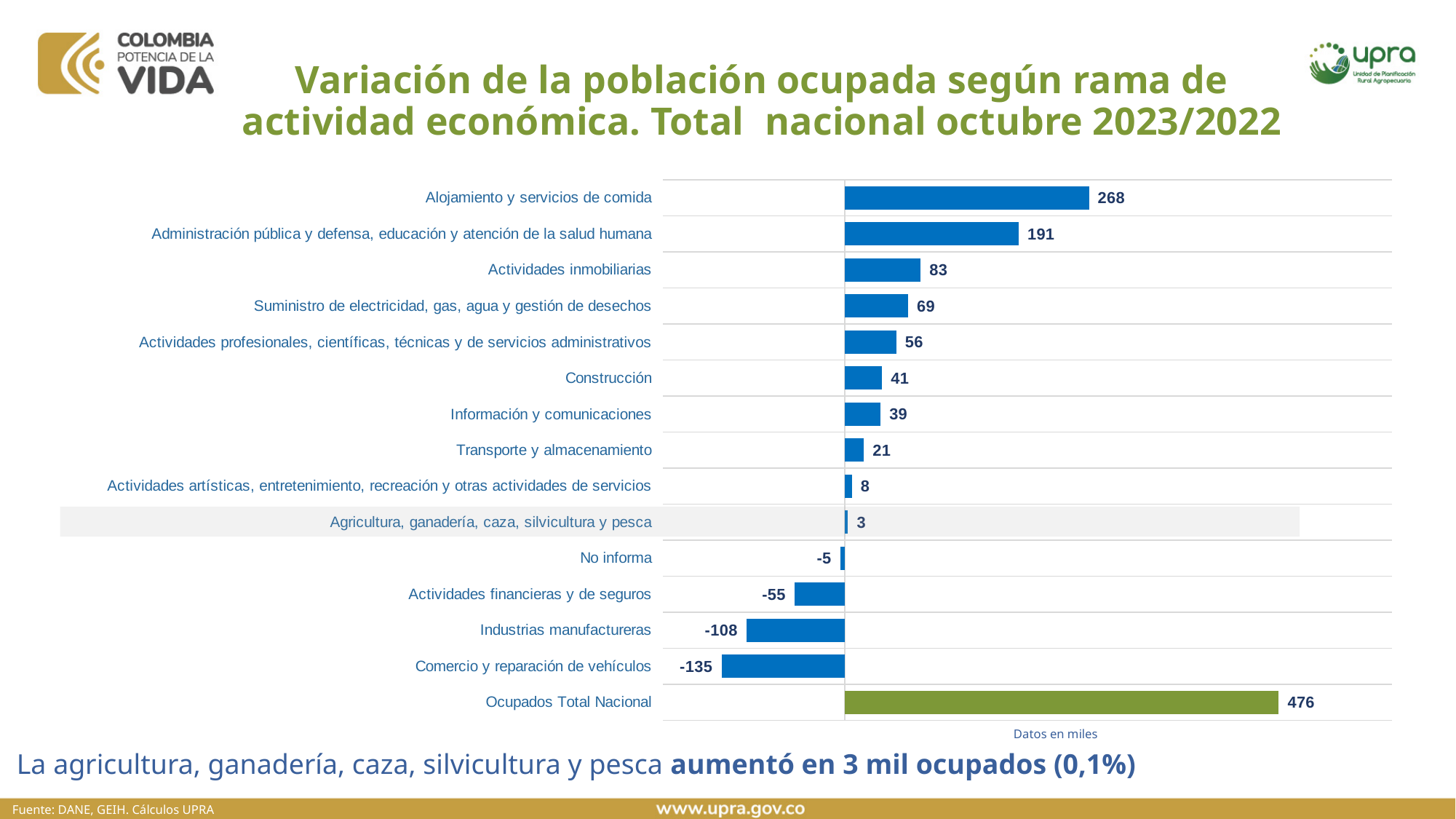
What is the value for Comercio y reparación de vehículos? -135 Which category has the lowest value? Comercio y reparación de vehículos What is the value for Ocupados Total Nacional? 476 What type of chart is shown on the slide? Bar chart What is the difference between the values for Alojamiento y servicios de comida and Administración pública y defensa, educación y atención de la salud humana? 77 What is the difference between the values for Actividades inmobiliarias and Suministro de electricidad, gas, agua y gestión de desechos? 14 What is the value for Agricultura, ganadería, caza, silvicultura y pesca? 3 What is the value for Alojamiento y servicios de comida? 268 Which is larger, the value for Construcción or the value for Información y comunicaciones? Construcción How many bars are plotted in the chart? 15 What unit note is printed below the chart? Datos en miles Excluding Ocupados Total Nacional, which rama de actividad has the highest value? Alojamiento y servicios de comida